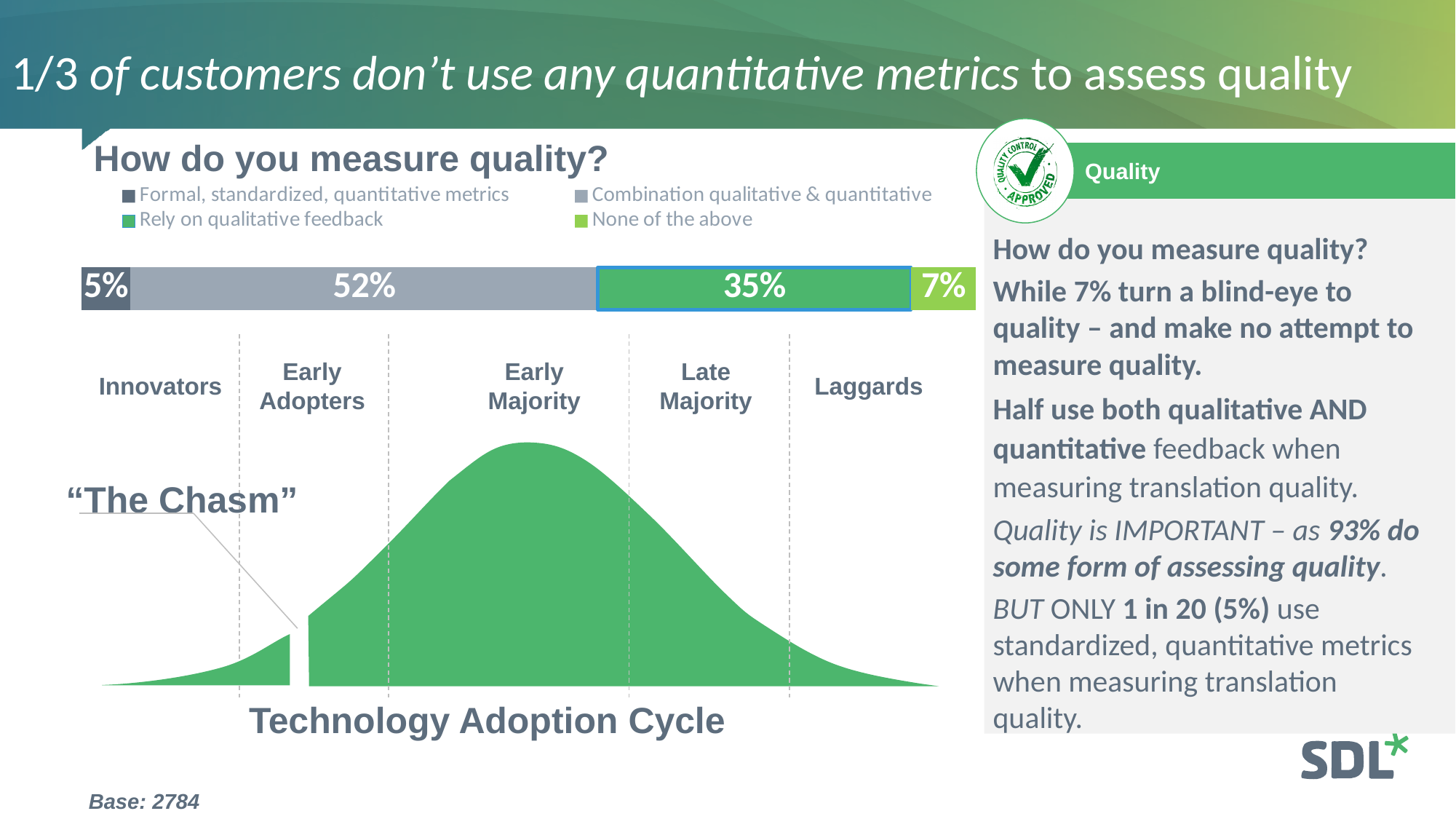
In the 'How do you measure quality?' chart, what percentage rely on qualitative feedback? 35% In the 'How do you measure quality?' chart, what is the difference between the 'Combination qualitative & quantitative' share and the 'Rely on qualitative feedback' share? 17% What type of chart is used to show the 'How do you measure quality?' results? Stacked bar chart What is the base (number of respondents) stated for the 'How do you measure quality?' chart? 2784 In the 'How do you measure quality?' chart, which is larger: 'Rely on qualitative feedback' or 'None of the above'? Rely on qualitative feedback In the 'How do you measure quality?' chart, which response has the smallest share? Formal, standardized, quantitative metrics In the 'How do you measure quality?' chart, what percentage answered 'None of the above'? 7% In the 'How do you measure quality?' chart, what percentage of respondents use formal, standardized, quantitative metrics? 5% In the 'How do you measure quality?' chart, what percentage use a combination of qualitative & quantitative measures? 52% In the 'How do you measure quality?' chart, what is the total of the four segments in the bar? 99% In the 'How do you measure quality?' chart, which response has the largest share? Combination qualitative & quantitative How many response categories does the legend of the 'How do you measure quality?' chart list? 4